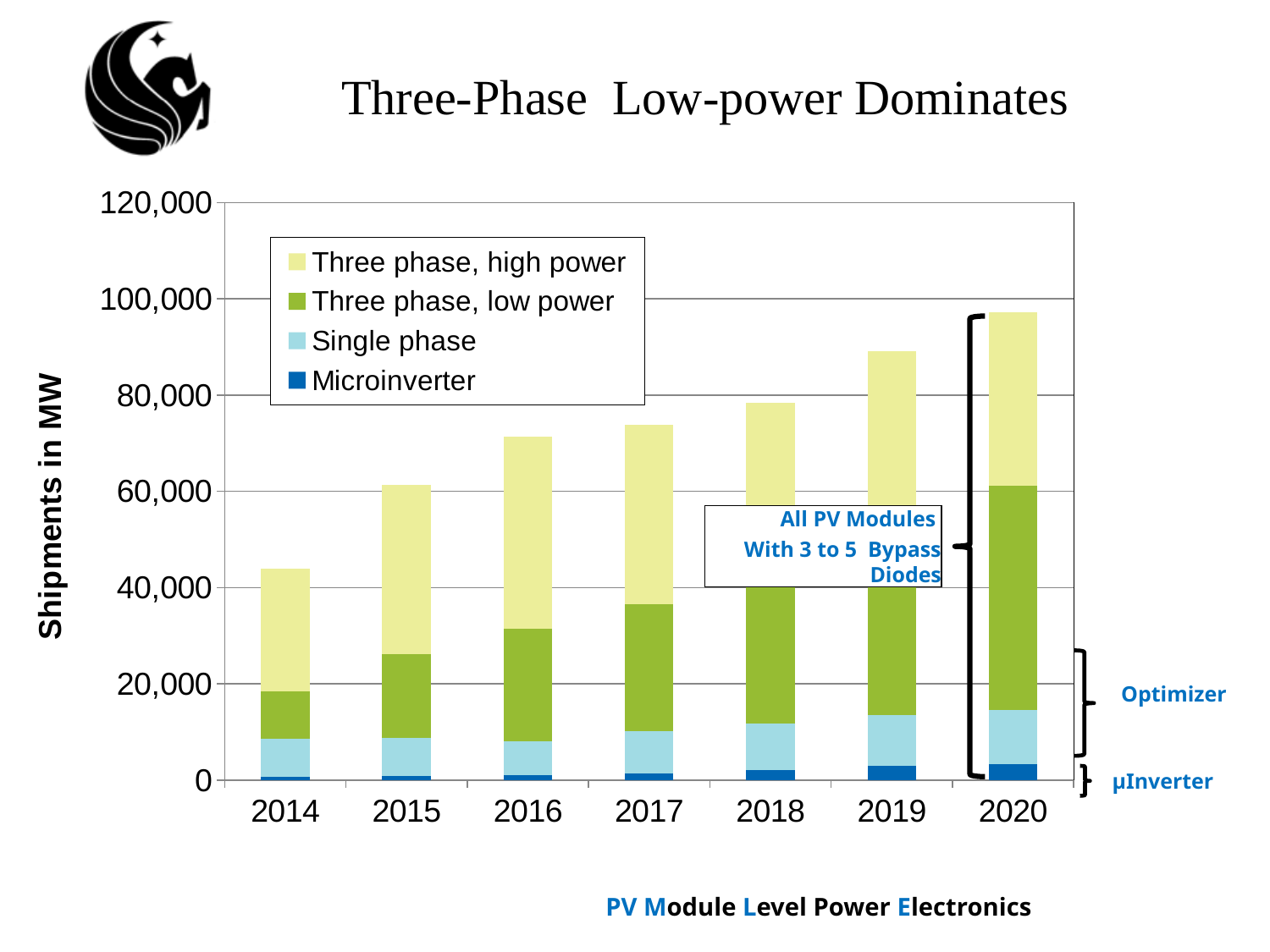
Which legend entry is shown in the darkest blue colour? Microinverter What kind of chart is shown on the slide? stacked bar chart Which year has the lowest total shipments? 2014 Is the total shipments value for 2014 greater or less than 40,000? greater What is the label of the y axis of the chart? Shipments in MW How many series does the chart's legend list? 4 Which year has the highest total shipments? 2020 Is the total shipments value for 2019 greater or less than 80,000? greater Which year has larger total shipments, 2016 or 2018? 2018 Do total shipments rise or fall from 2014 to 2020? rise How many years are shown on the x axis of the chart? 7 Is the total shipments value for 2020 greater or less than 100,000? less